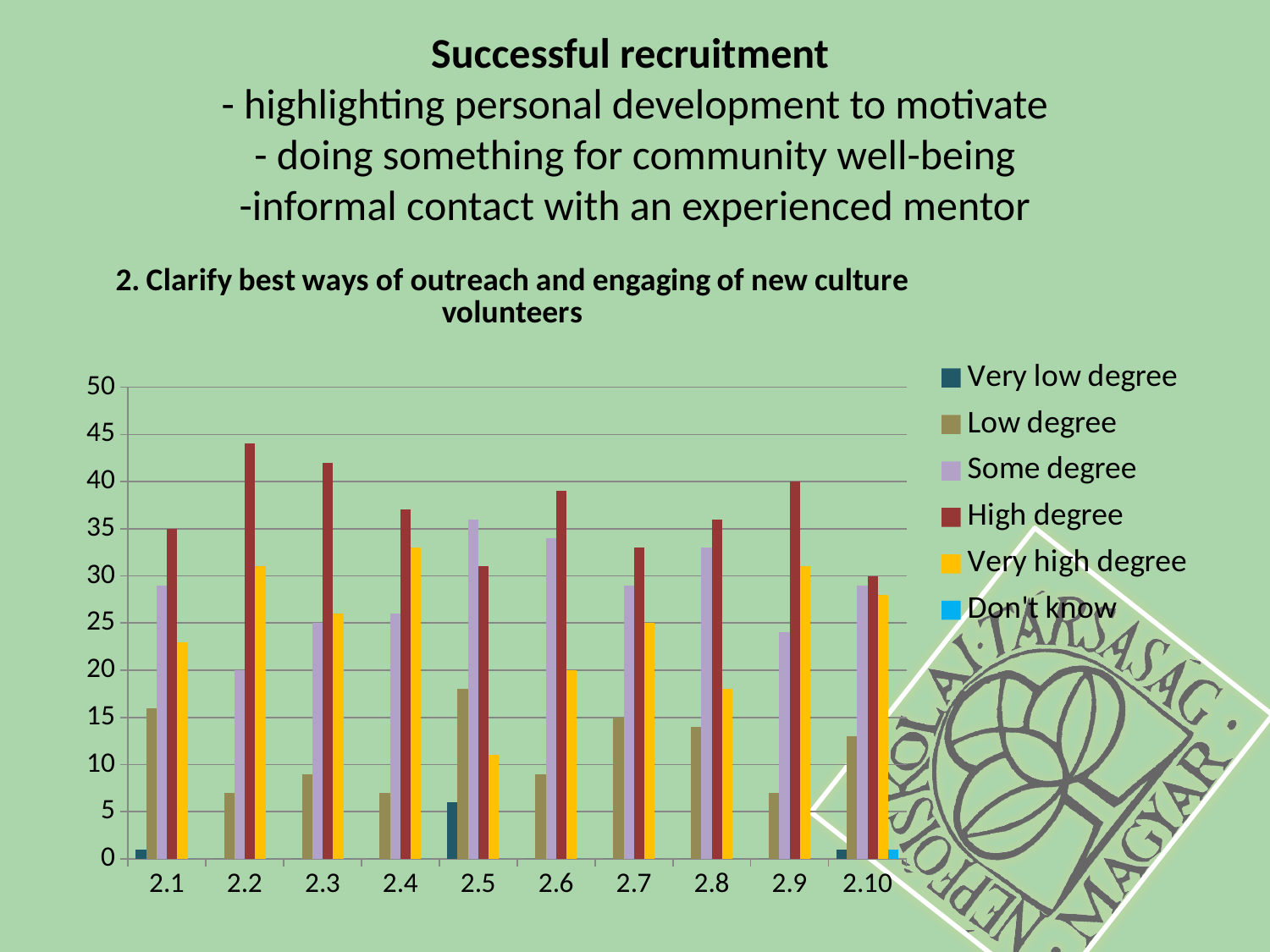
What is the value of the High degree bar for category 2.9? 40 Is the Very high degree value for category 2.10 greater or less than 25? greater What is the title of the chart? 2. Clarify best ways of outreach and engaging of new culture volunteers How many categories are shown on the x axis? 10 Is the High degree value for category 2.2 greater or less than 40? greater For category 2.5, which is larger: the Some degree bar or the High degree bar? Some degree How many series does the legend list? 6 Is the Low degree value for category 2.5 greater or less than 15? greater Which category has the highest High degree bar? 2.2 What is the value of the Very high degree bar for category 2.6? 20 What kind of chart is shown on the slide? bar chart What is the value of the High degree bar for category 2.1? 35